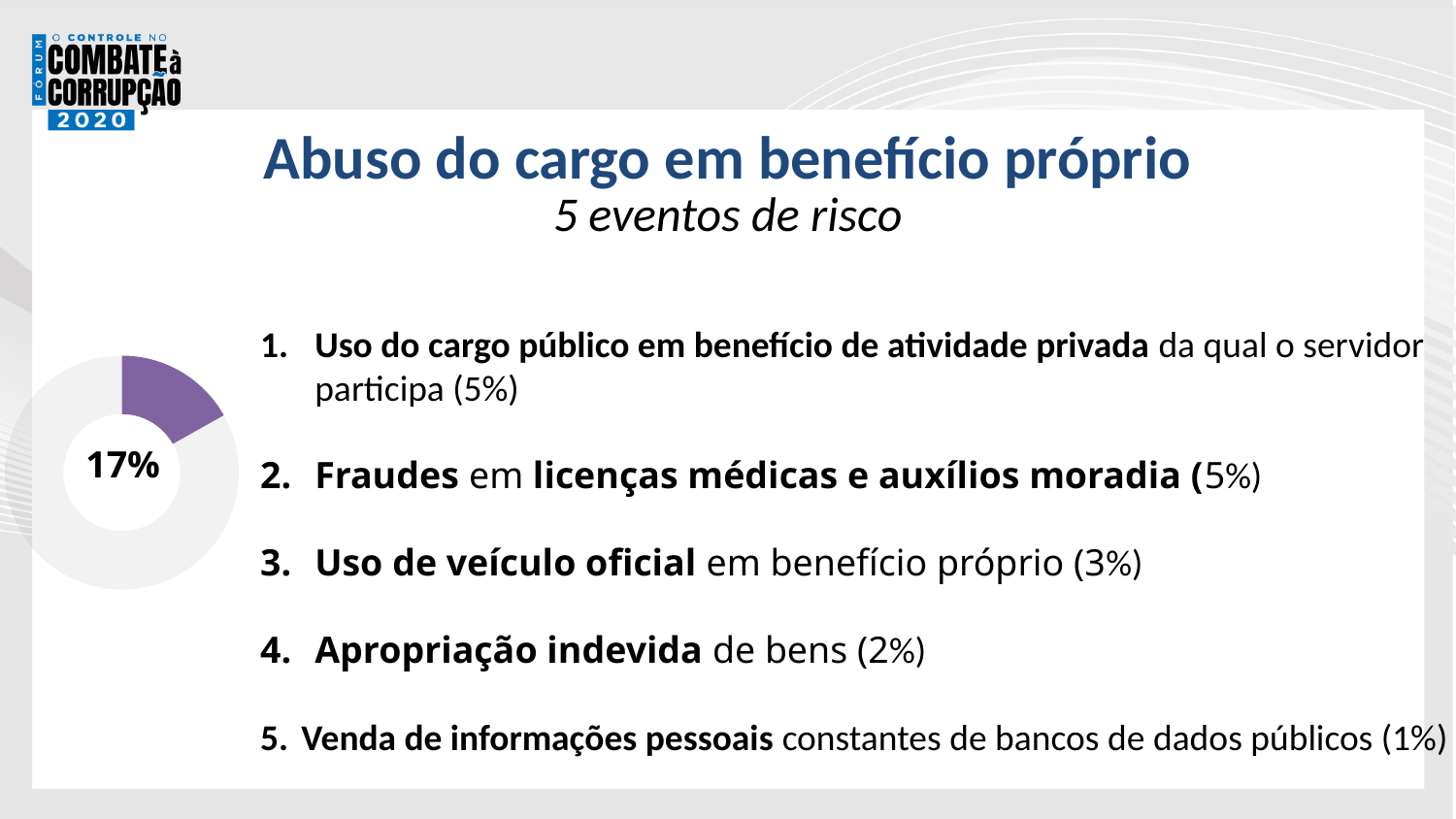
What percentage is printed in the centre of the doughnut chart? 17% What kind of chart is shown on the left of the slide? Doughnut chart What colour is the highlighted slice of the doughnut chart? Purple Is the highlighted slice of the doughnut chart larger or smaller than the remaining (white) portion? Smaller Does the doughnut chart have a legend? No What share of the doughnut does the purple (highlighted) slice represent? 17% How many slices does the doughnut chart show? 2